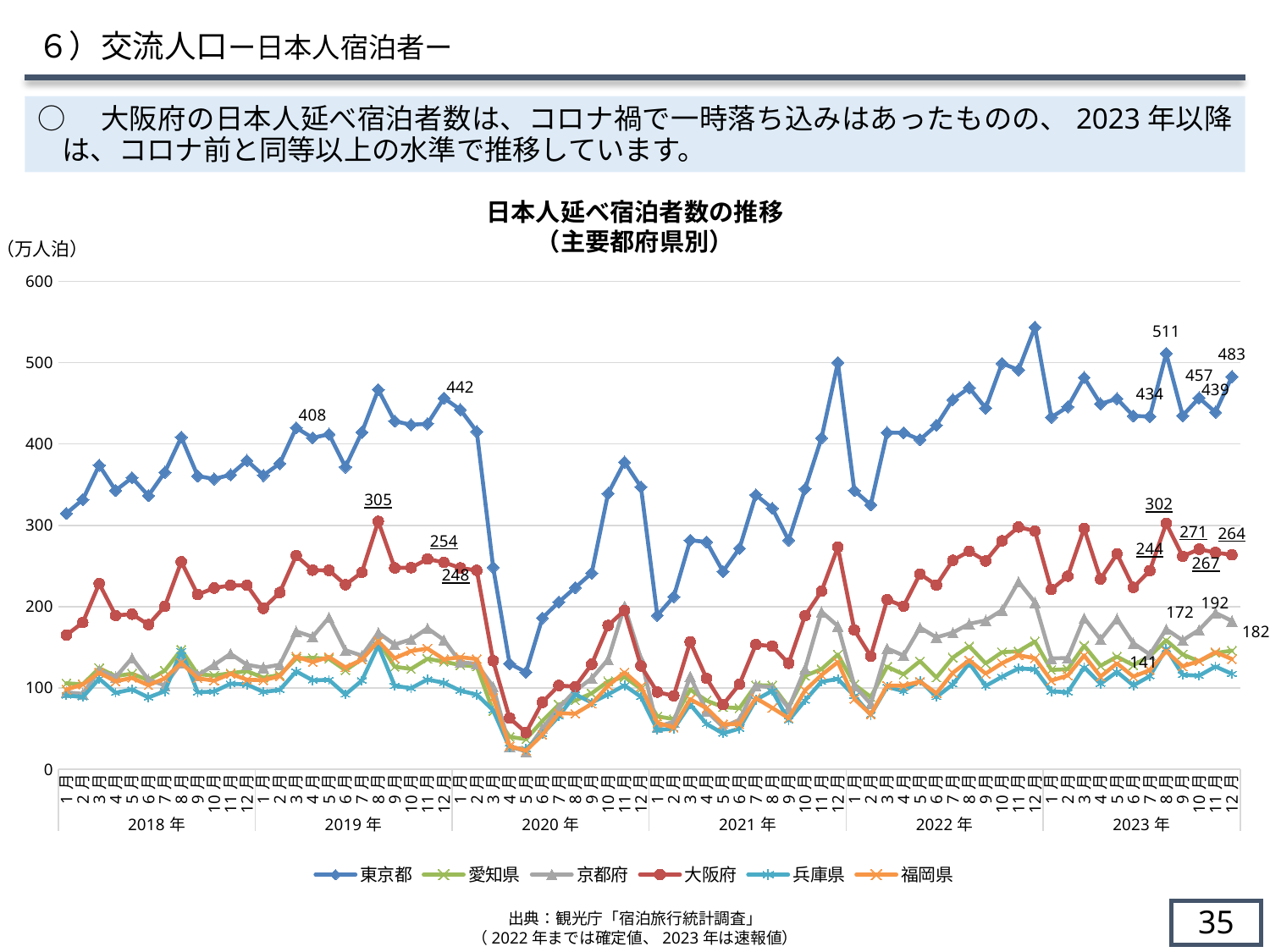
How many series does the legend list? 6 What kind of chart is shown on the slide? line chart What is the value for 大阪府 in 2023年8月? 302 What is the value for 東京都 in 2023年12月? 483 What is the difference between 東京都 and 大阪府 in 2023年12月? 219 What unit is shown for the vertical axis? 万人泊 Which series has the highest values throughout the chart? 東京都 What is the value for 京都府 in 2023年11月? 192 Which is larger for 大阪府: the value in 2019年8月 or the value in 2023年8月? 2019年8月 Is the value for 東京都 in 2020年5月 greater or less than 200? less What is the difference between the 大阪府 values for 2023年10月 and 2023年11月? 4